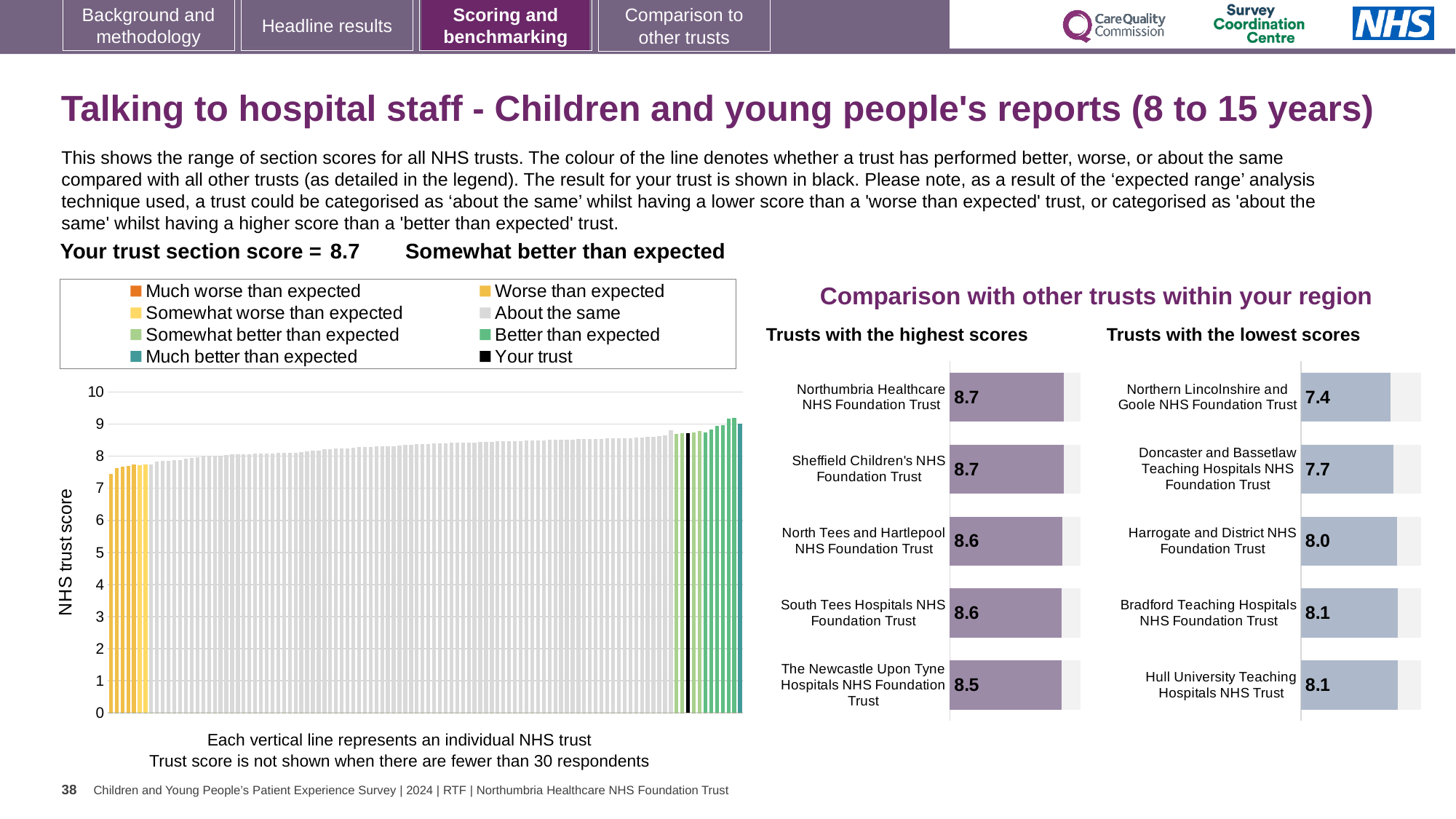
In the 'Trusts with the highest scores' chart, which trust has the lowest score shown? The Newcastle Upon Tyne Hospitals NHS Foundation Trust What kind of chart is the large 'NHS trust score' chart on the left? bar chart In the large 'NHS trust score' chart on the left, is the value of the leftmost yellow bar greater or less than 7? greater What is the difference between Northumbria Healthcare NHS Foundation Trust's score in the 'Trusts with the highest scores' chart and Northern Lincolnshire and Goole NHS Foundation Trust's score in the 'Trusts with the lowest scores' chart? 1.3 How many trusts are listed in the 'Trusts with the highest scores' chart? 5 In the 'Trusts with the lowest scores' chart, which trust has the lowest score? Northern Lincolnshire and Goole NHS Foundation Trust In the 'Trusts with the lowest scores' chart, which has the higher score: Doncaster and Bassetlaw Teaching Hospitals NHS Foundation Trust or Harrogate and District NHS Foundation Trust? Harrogate and District NHS Foundation Trust In the large 'NHS trust score' chart on the left, do the bar values rise or fall from left to right? rise In the large 'NHS trust score' chart on the left, is the value of the black bar for your trust greater or less than 8? greater How many entries does the legend above the large 'NHS trust score' chart list? 8 In the 'Trusts with the highest scores' chart, what is the score for North Tees and Hartlepool NHS Foundation Trust? 8.6 In the 'Trusts with the lowest scores' chart, what is the score for Doncaster and Bassetlaw Teaching Hospitals NHS Foundation Trust? 7.7